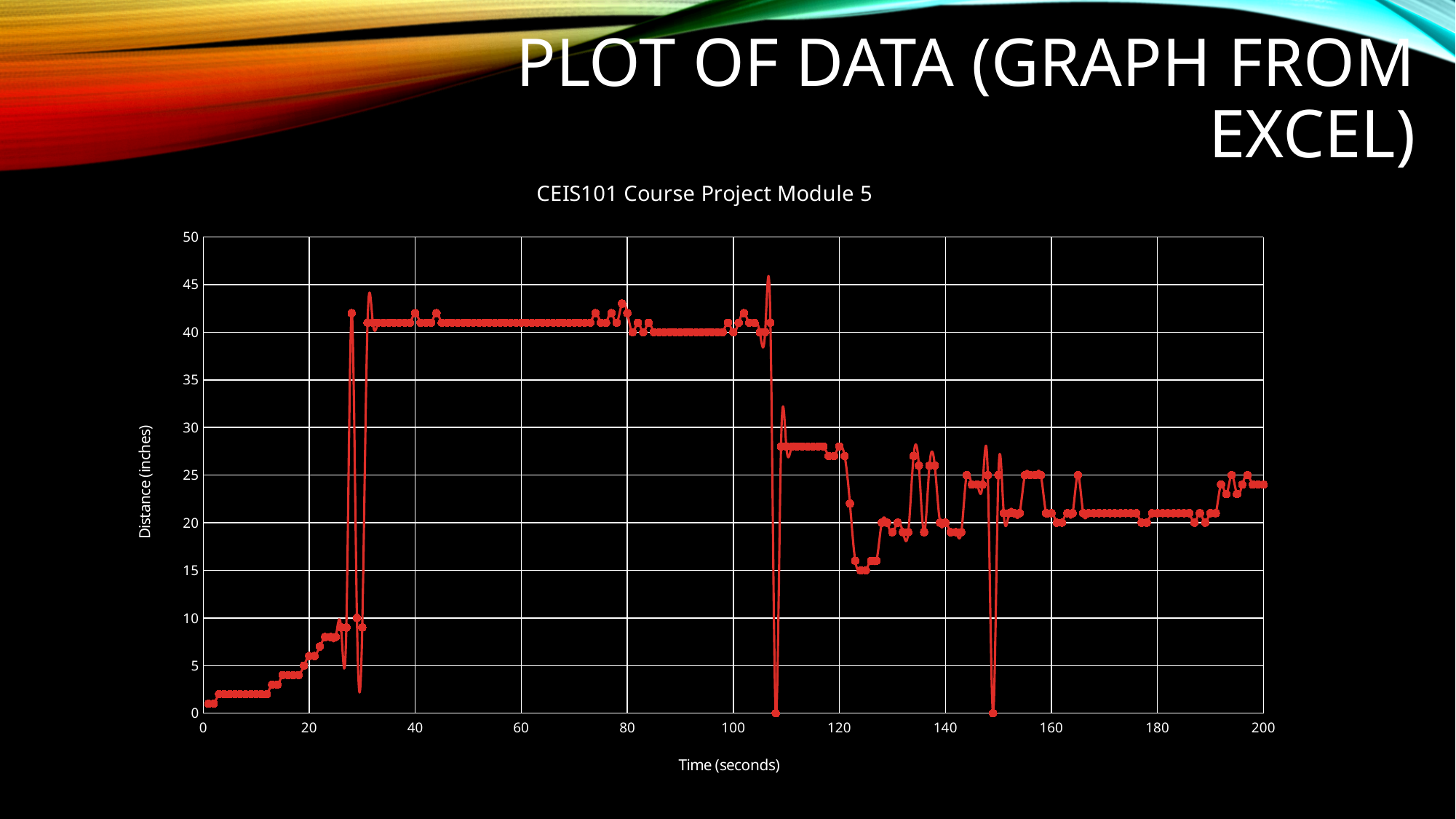
Is the value at 125 seconds greater or less than 20? less Is the value at 110 seconds greater or less than 25? greater Is the value at 180 seconds greater or less than 25? less Do the values rise or fall between 100 and 120 seconds? fall What is the title of the chart? CEIS101 Course Project Module 5 What is the label of the vertical axis? Distance (inches) Which is larger, the value at 10 seconds or the value at 110 seconds? 110 seconds Which is larger, the value at 60 seconds or the value at 160 seconds? 60 seconds Do the values rise or fall between 0 and 20 seconds? rise What kind of chart is shown on the slide? line chart